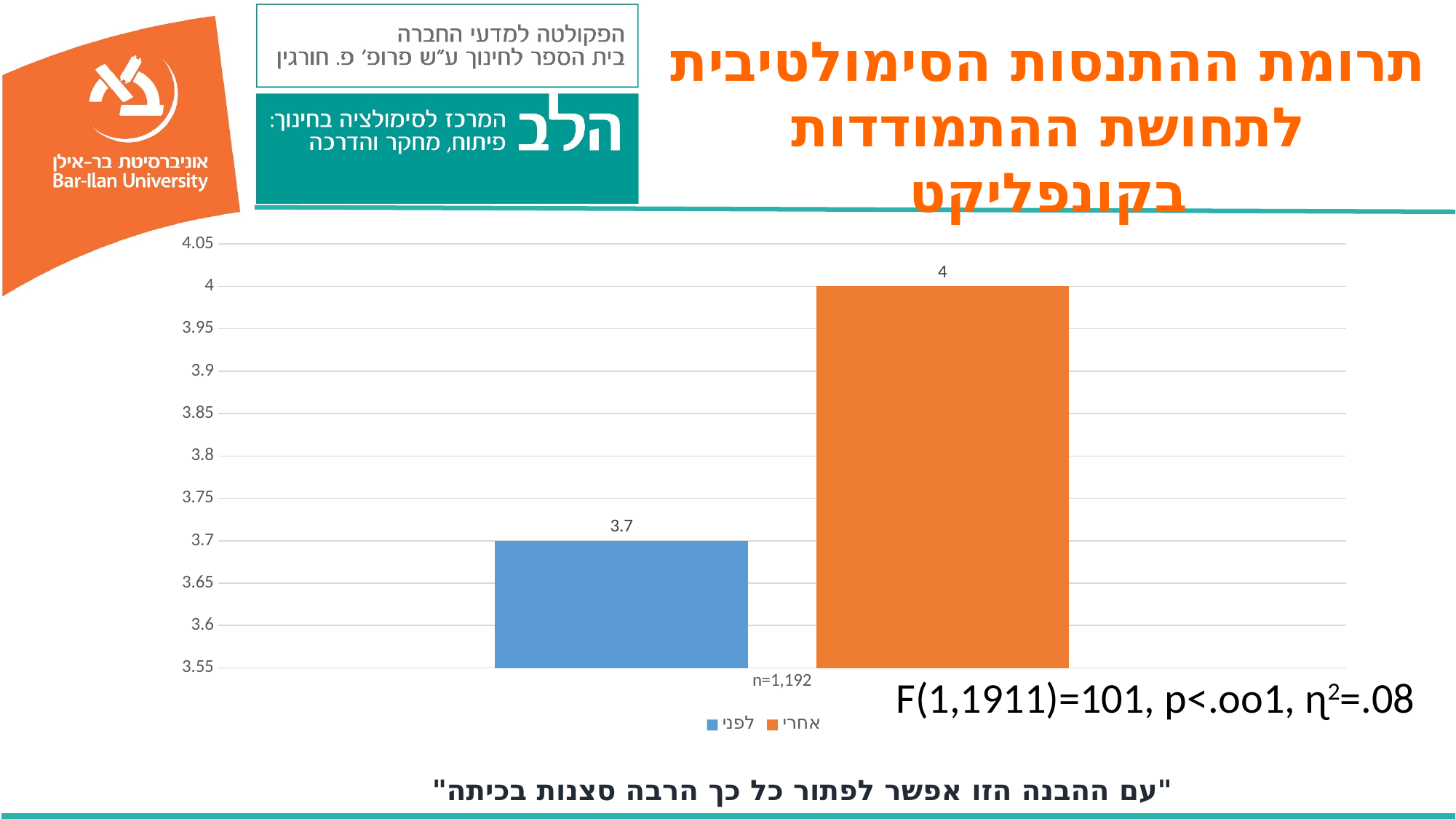
Is the value for לפני greater or less than 3.8? less How many series does the legend list? 2 Is the value for אחרי greater or less than 3.9? greater What kind of chart is shown on the slide? bar chart Is the value for לפני larger or smaller than the value for אחרי? smaller Which bar is higher, לפני or אחרי? אחרי What is the difference between the אחרי value and the לפני value? 0.3 Which bar is lower, לפני or אחרי? לפני What is the value for אחרי (after)? 4 What colour is the bar for אחרי? orange What is the value for לפני (before)? 3.7 How many bars are plotted in the chart? 2